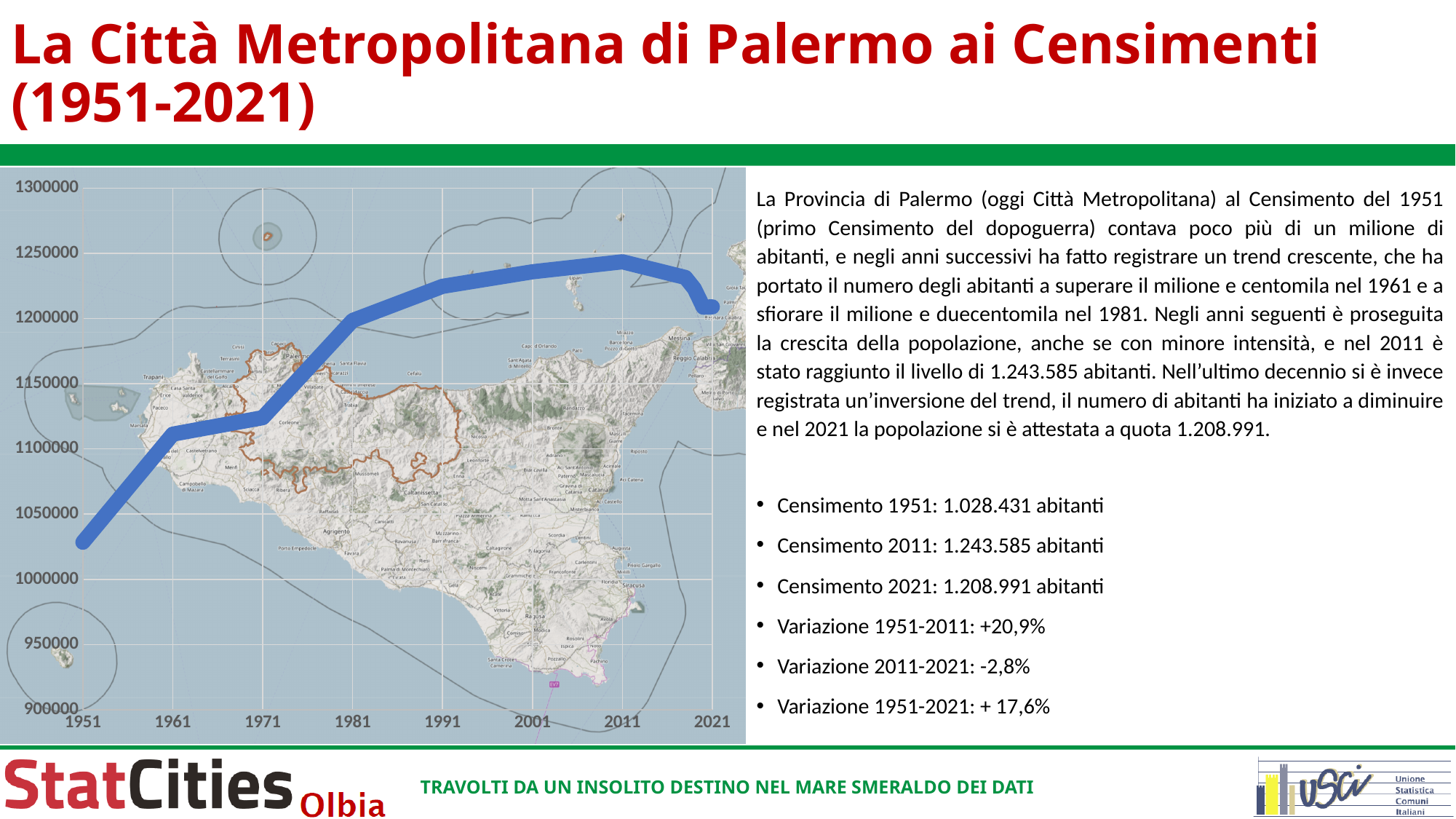
How does the population change along the x axis from 1951 to 2021? It rises from 1951 to 2011, then falls to 2021 Is the plotted value for 1991 greater or less than 1200000? greater What was the population at the 2021 census, as stated on the slide? 1.208.991 Is the plotted value for 1971 greater or less than 1150000? less What colour is the line plotted on the chart? blue In which census year does the plotted population reach its highest value? 2011 What was the population at the 2011 census, as stated on the slide? 1.243.585 By how much did the population decrease between the 2011 and 2021 censuses? 34.594 What kind of chart is shown on the slide? line chart In which census year is the plotted population at its lowest? 1951 How many census years are plotted along the x axis of the chart? 8 What was the population of the Città Metropolitana di Palermo at the 1951 census, as stated on the slide? 1.028.431